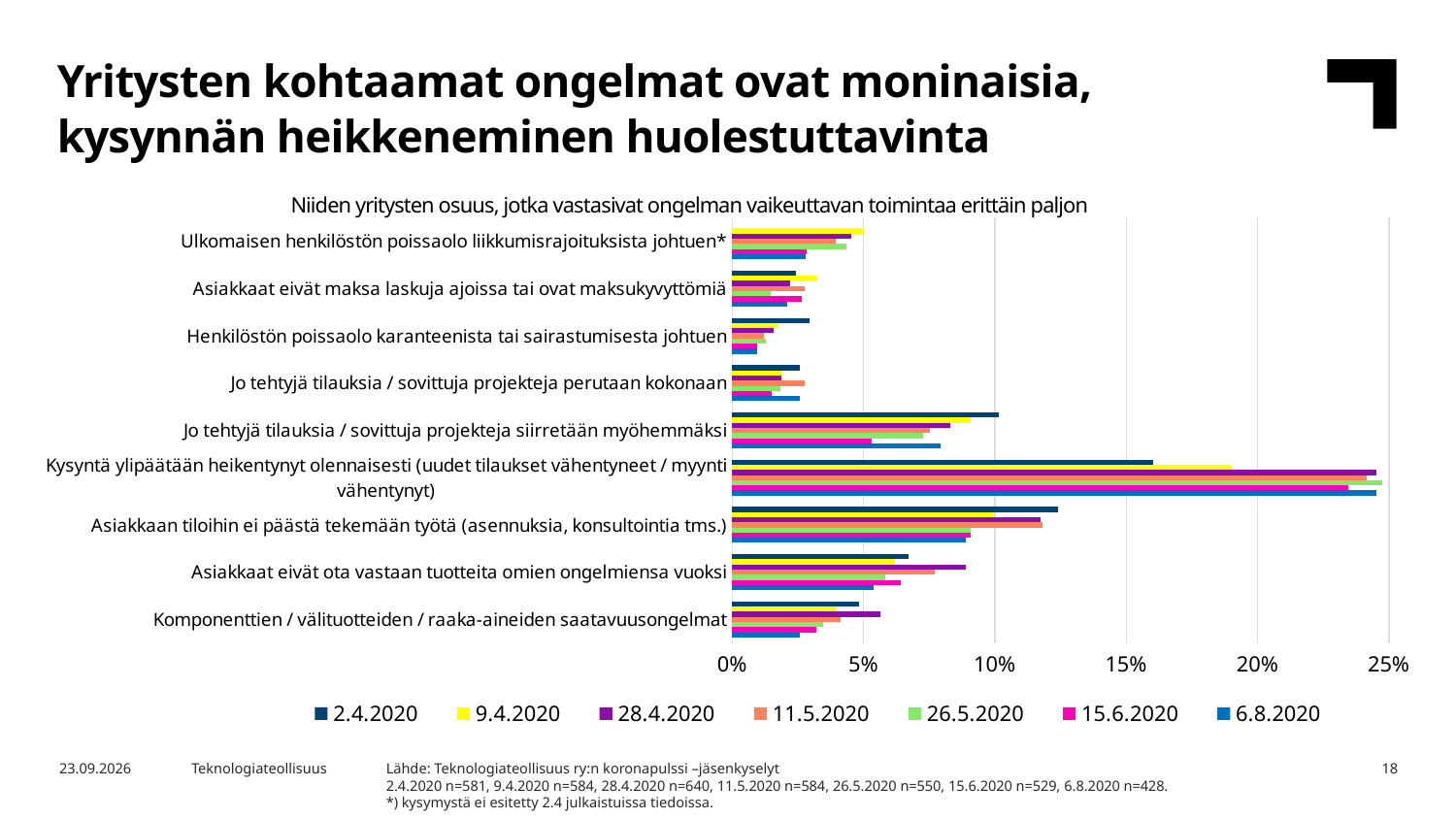
Is the 2.4.2020 value for 'Henkilöstön poissaolo karanteenista tai sairastumisesta johtuen' greater or less than 5%? less For 28.4.2020, which is larger: 'Asiakkaat eivät ota vastaan tuotteita omien ongelmiensa vuoksi' or 'Komponenttien / välituotteiden / raaka-aineiden saatavuusongelmat'? Asiakkaat eivät ota vastaan tuotteita omien ongelmiensa vuoksi Is the 26.5.2020 value for 'Kysyntä ylipäätään heikentynyt olennaisesti' greater or less than 20%? greater What is the title of the chart? Niiden yritysten osuus, jotka vastasivat ongelman vaikeuttavan toimintaa erittäin paljon Which survey date is the first entry in the legend? 2.4.2020 Is the 2.4.2020 value for 'Asiakkaan tiloihin ei päästä tekemään työtä' greater or less than 10%? greater What kind of chart is shown on the slide? Bar chart How many problem categories are listed on the chart? 9 Which category has the highest values across the survey dates? Kysyntä ylipäätään heikentynyt olennaisesti (uudet tilaukset vähentyneet / myynti vähentynyt) How many series (survey dates) does the legend list? 7 For 2.4.2020, which is larger: 'Kysyntä ylipäätään heikentynyt olennaisesti' or 'Asiakkaan tiloihin ei päästä tekemään työtä'? Kysyntä ylipäätään heikentynyt olennaisesti